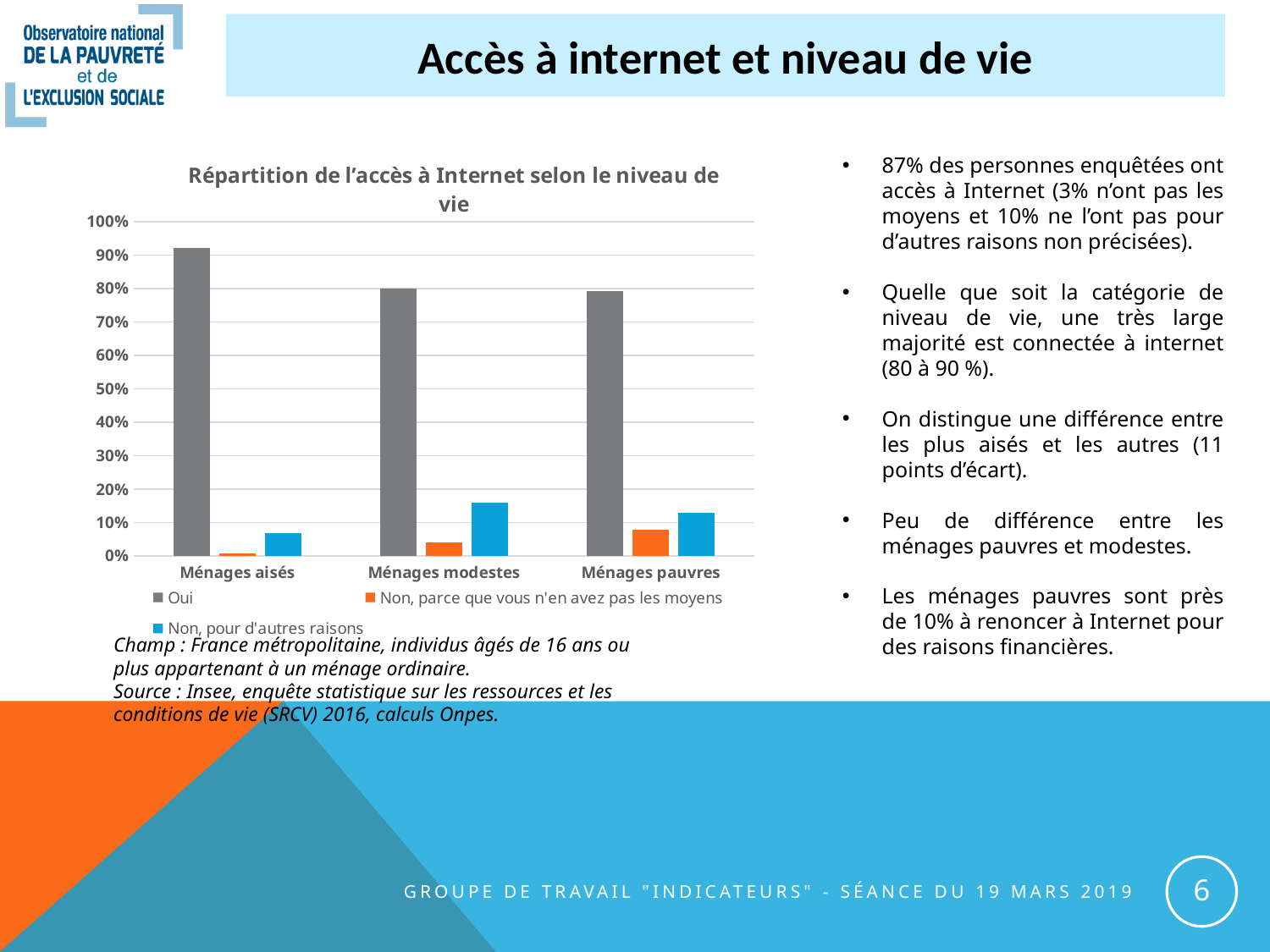
What colour are the bars for the 'Oui' series? grey Which has the larger 'Oui' value, Ménages aisés or Ménages pauvres? Ménages aisés Is the 'Non, pour d'autres raisons' value for Ménages modestes greater or less than 10%? greater Which household category has the highest value for 'Non, pour d'autres raisons'? Ménages modestes What is the title of the chart? Répartition de l'accès à Internet selon le niveau de vie Is the 'Non, parce que vous n'en avez pas les moyens' value for Ménages pauvres greater or less than 10%? less Which household category has the lowest value for 'Non, parce que vous n'en avez pas les moyens'? Ménages aisés What kind of chart is shown on the slide? bar chart Is the 'Oui' value for Ménages aisés greater or less than 90%? greater How many series does the legend of the chart list? 3 How many household categories are shown on the x axis of the chart? 3 Which household category has the highest value for the 'Oui' series? Ménages aisés